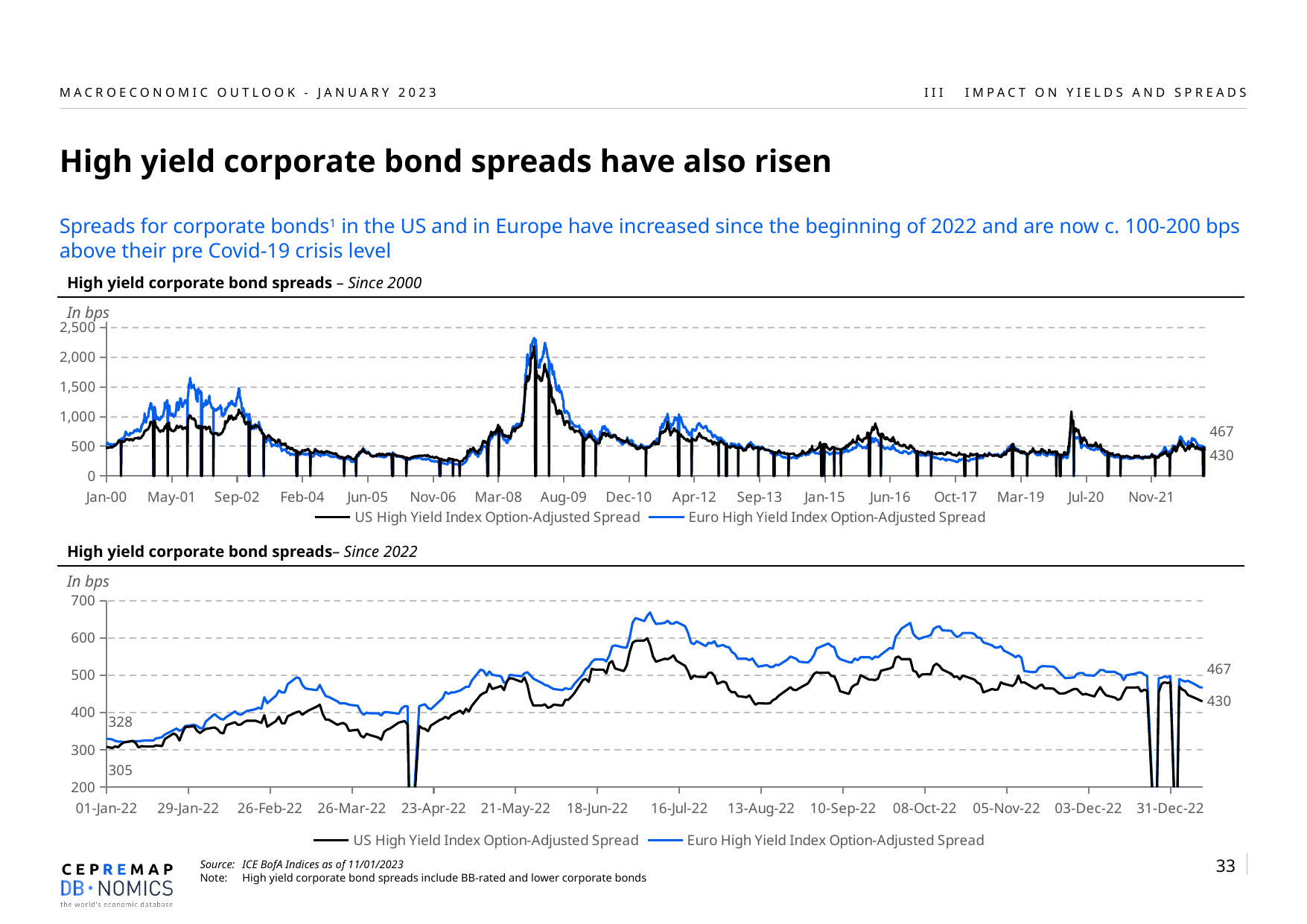
What unit is shown on the y axis of both charts on the slide? In bps How many series does the legend of the 'High yield corporate bond spreads – Since 2000' chart list? 2 In the 'High yield corporate bond spreads – Since 2022' chart, is the peak of the Euro High Yield Index Option-Adjusted Spread around mid-July 2022 greater or less than 600? greater In the 'High yield corporate bond spreads – Since 2000' chart, is the peak of the US High Yield Index Option-Adjusted Spread around 2008-2009 greater or less than 2,000? greater In the 'High yield corporate bond spreads – Since 2022' chart, by how much did the US High Yield Index Option-Adjusted Spread rise from its starting value of 305 to its latest value? 125 In the 'High yield corporate bond spreads – Since 2022' chart, what is the difference between the latest Euro spread and the latest US spread? 37 In the 'High yield corporate bond spreads – Since 2022' chart, what was the US High Yield Index Option-Adjusted Spread at the start of the series on 01-Jan-22? 305 In the 'High yield corporate bond spreads – Since 2022' chart, what is the latest value of the US High Yield Index Option-Adjusted Spread? 430 In the 'High yield corporate bond spreads – Since 2022' chart, what is the latest value of the Euro High Yield Index Option-Adjusted Spread? 467 In the 'High yield corporate bond spreads – Since 2022' chart, what was the Euro High Yield Index Option-Adjusted Spread at the start of the series on 01-Jan-22? 328 In the 'High yield corporate bond spreads – Since 2000' chart, which series has the higher latest value, the US or the Euro High Yield Index Option-Adjusted Spread? Euro High Yield Index Option-Adjusted Spread What kind of chart is the 'High yield corporate bond spreads – Since 2022' chart? Line chart